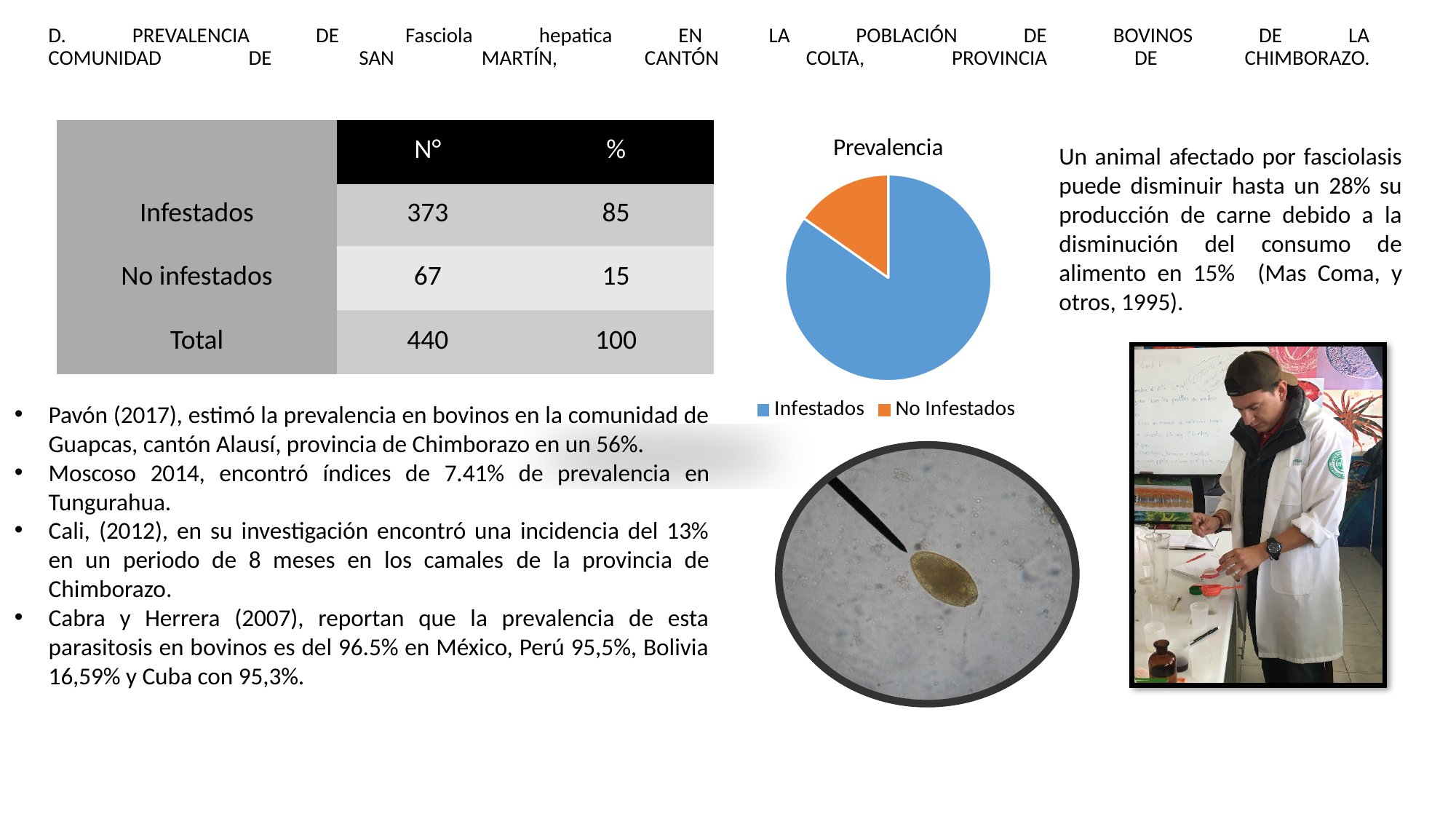
What kind of chart is shown under the title "Prevalencia"? pie chart How many entries does the legend of the "Prevalencia" pie chart list? 2 What is the title of the pie chart? Prevalencia Which category has the smallest slice in the "Prevalencia" pie chart? No Infestados What are the two legend entries of the "Prevalencia" pie chart? Infestados and No Infestados In the "Prevalencia" pie chart, is the Infestados slice more or less than half of the pie? more In the "Prevalencia" pie chart, which slice is larger, Infestados or No Infestados? Infestados How many slices does the "Prevalencia" pie chart have? 2 What colour is the Infestados slice in the "Prevalencia" pie chart? blue Which category has the largest slice in the "Prevalencia" pie chart? Infestados